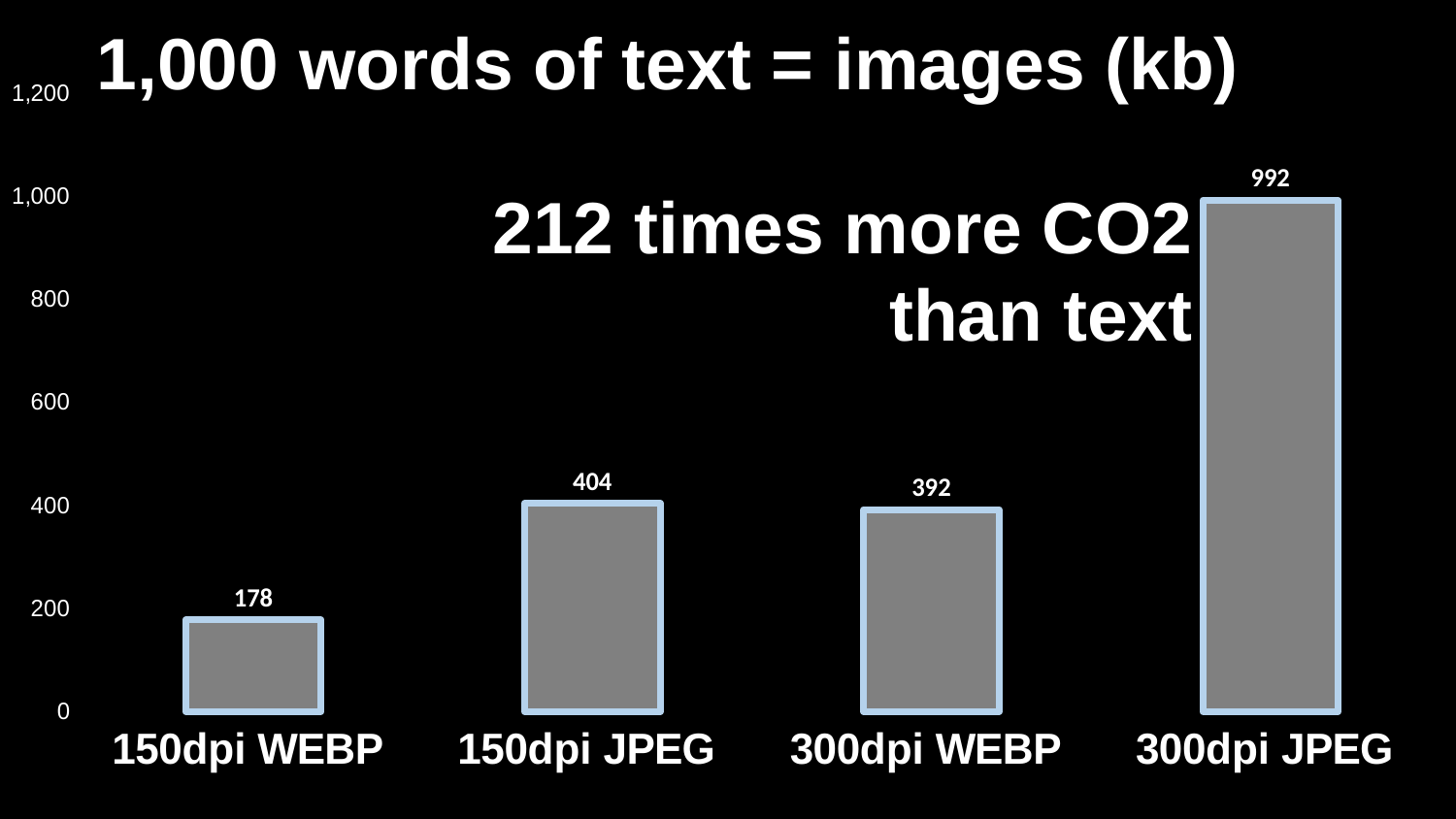
What is the value for 300dpi JPEG? 992 What is the value for 300dpi WEBP? 392 How many categories are shown on the x axis? 4 What is the difference between the values for 300dpi JPEG and 150dpi WEBP? 814 What is the value for 150dpi JPEG? 404 What is the value for 150dpi WEBP? 178 What is the title of the chart? 1,000 words of text = images (kb) What kind of chart is shown on the slide? bar chart Which category has the highest value? 300dpi JPEG What is the difference between the values for 150dpi JPEG and 300dpi WEBP? 12 Which is larger, the value for 300dpi JPEG or the value for 150dpi JPEG? 300dpi JPEG Which category has the lowest value? 150dpi WEBP